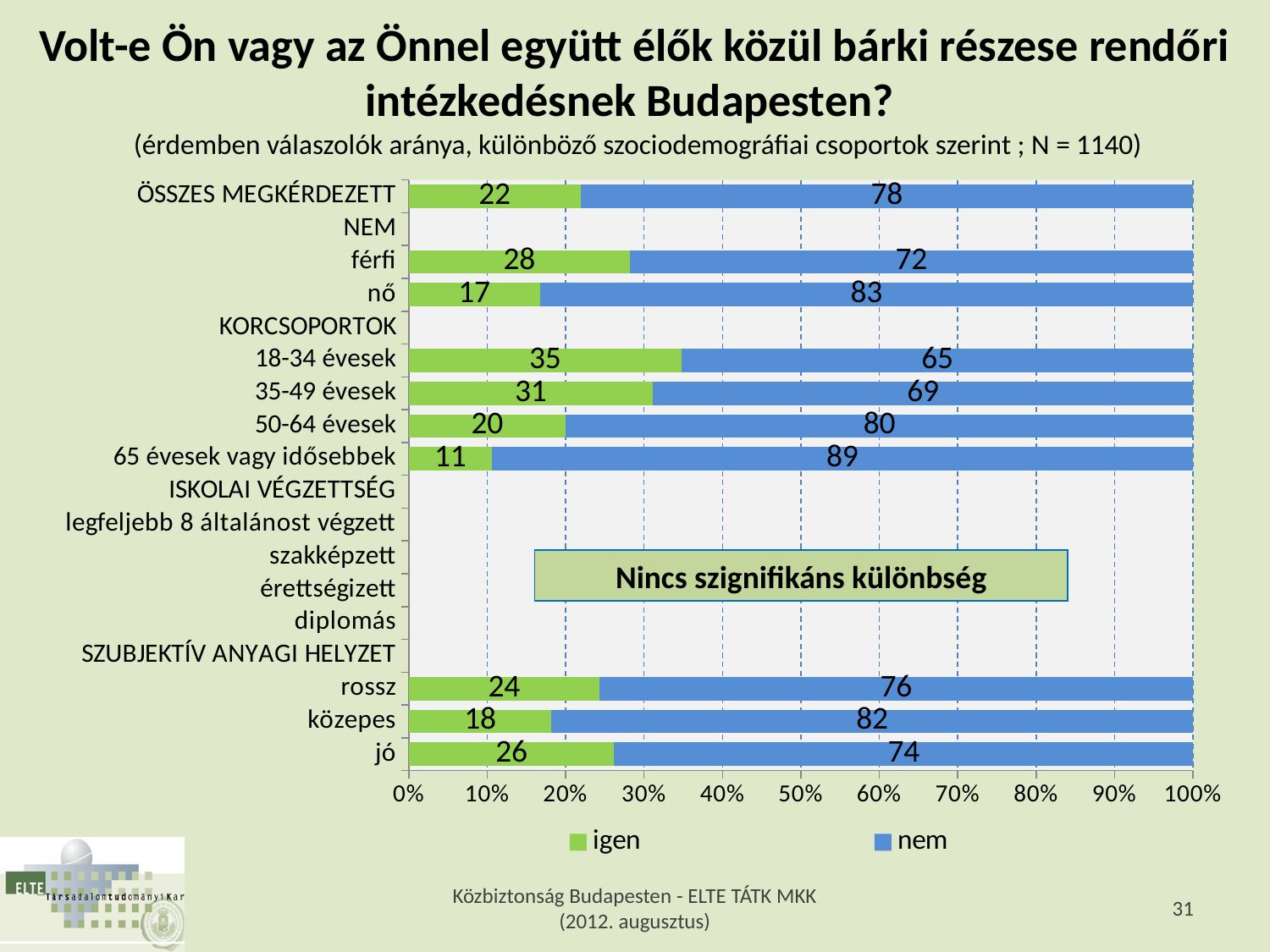
How many series does the legend list? 2 Among the age groups (KORCSOPORTOK), which category has the highest "igen" value? 18-34 évesek What are the two legend entries of the chart? igen, nem What is the value of the "nem" series for "65 évesek vagy idősebbek"? 89 Which has a larger "igen" value, "rossz" or "jó"? jó Which category has the lowest "igen" value in the chart? 65 évesek vagy idősebbek What is the difference between the "igen" values for "férfi" and "nő"? 11 What kind of chart is shown on the slide? Stacked bar chart What is the value of the "nem" series for "közepes"? 82 What is the total of the stacked bar for "ÖSSZES MEGKÉRDEZETT"? 100 What is the value of the "igen" series for "férfi"? 28 What text is shown in the box placed over the ISKOLAI VÉGZETTSÉG rows of the chart? Nincs szignifikáns különbség